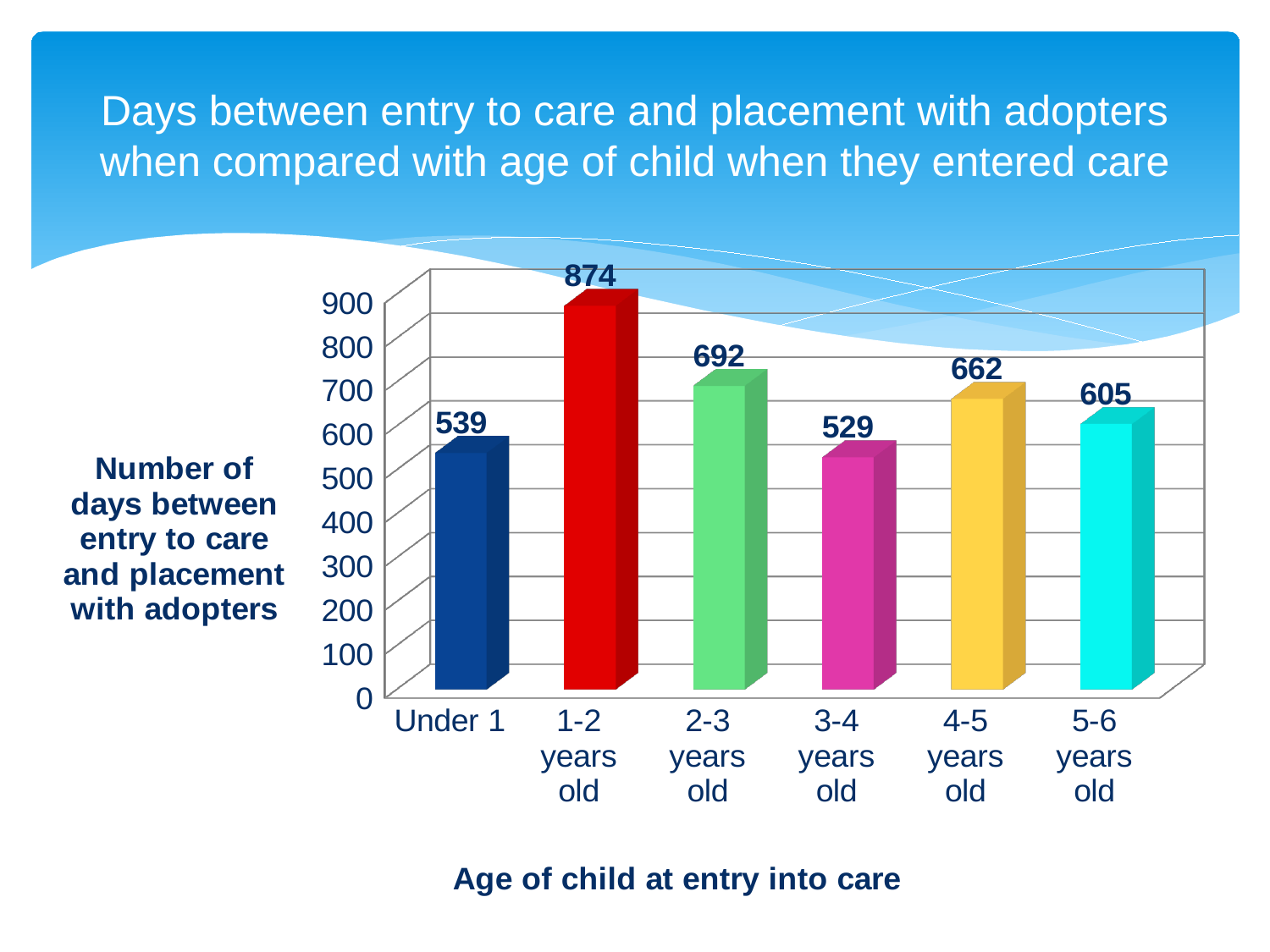
How many age groups are shown on the chart? 6 Which age group has the lowest number of days between entry to care and placement with adopters? 3-4 years old What is the value for children aged 4-5 years old? 662 What is the number of days between entry to care and placement with adopters for children aged 1-2 years old? 874 Is the value for 5-6 years old greater or less than 700? less What is the difference in days between the 1-2 years old group and the 3-4 years old group? 345 What is the value for children under 1? 539 What is the label of the horizontal axis? Age of child at entry into care What kind of chart is shown on the slide? Bar chart What is the difference in days between the 2-3 years old group and the 5-6 years old group? 87 Which has a higher value: 2-3 years old or 4-5 years old? 2-3 years old Which age group has the highest number of days between entry to care and placement with adopters? 1-2 years old